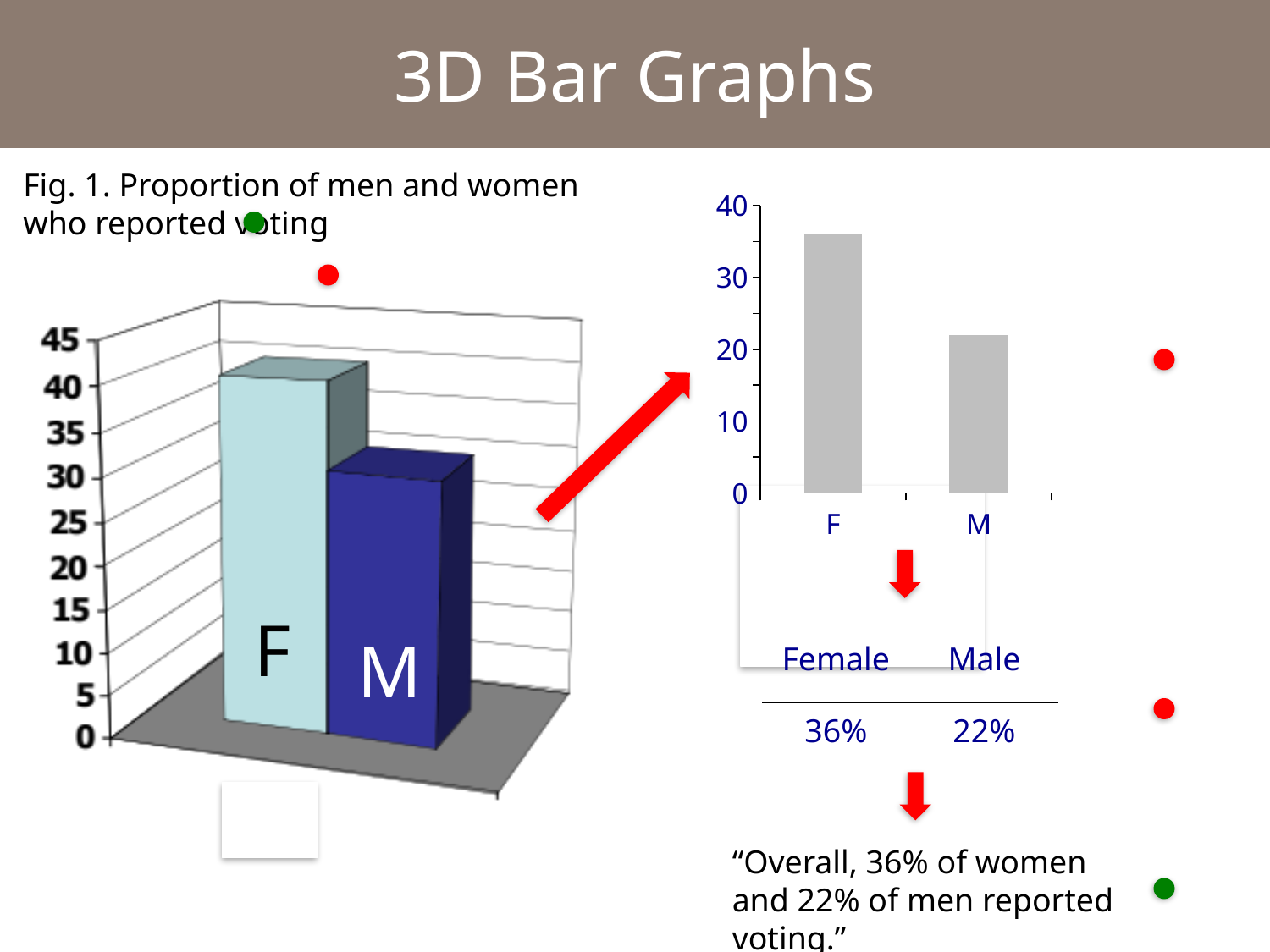
What kind of chart is the right chart? bar chart How many bars are shown in the left chart (Fig. 1)? 2 What is the caption of the left chart (Fig. 1)? Proportion of men and women who reported voting In the right chart, what percentage is shown for Male? 22% In the right chart, what is the difference between the Female and Male percentages? 14% In the right chart, what percentage is shown for Female? 36% How many categories are shown in the right chart? 2 In the right chart, which category has the lowest bar? M What kind of chart is the left chart (Fig. 1)? bar chart In the right chart, is the value for F greater or less than 30? greater In the right chart, which category has the highest bar? F In the left chart (Fig. 1), which bar is taller, F or M? F